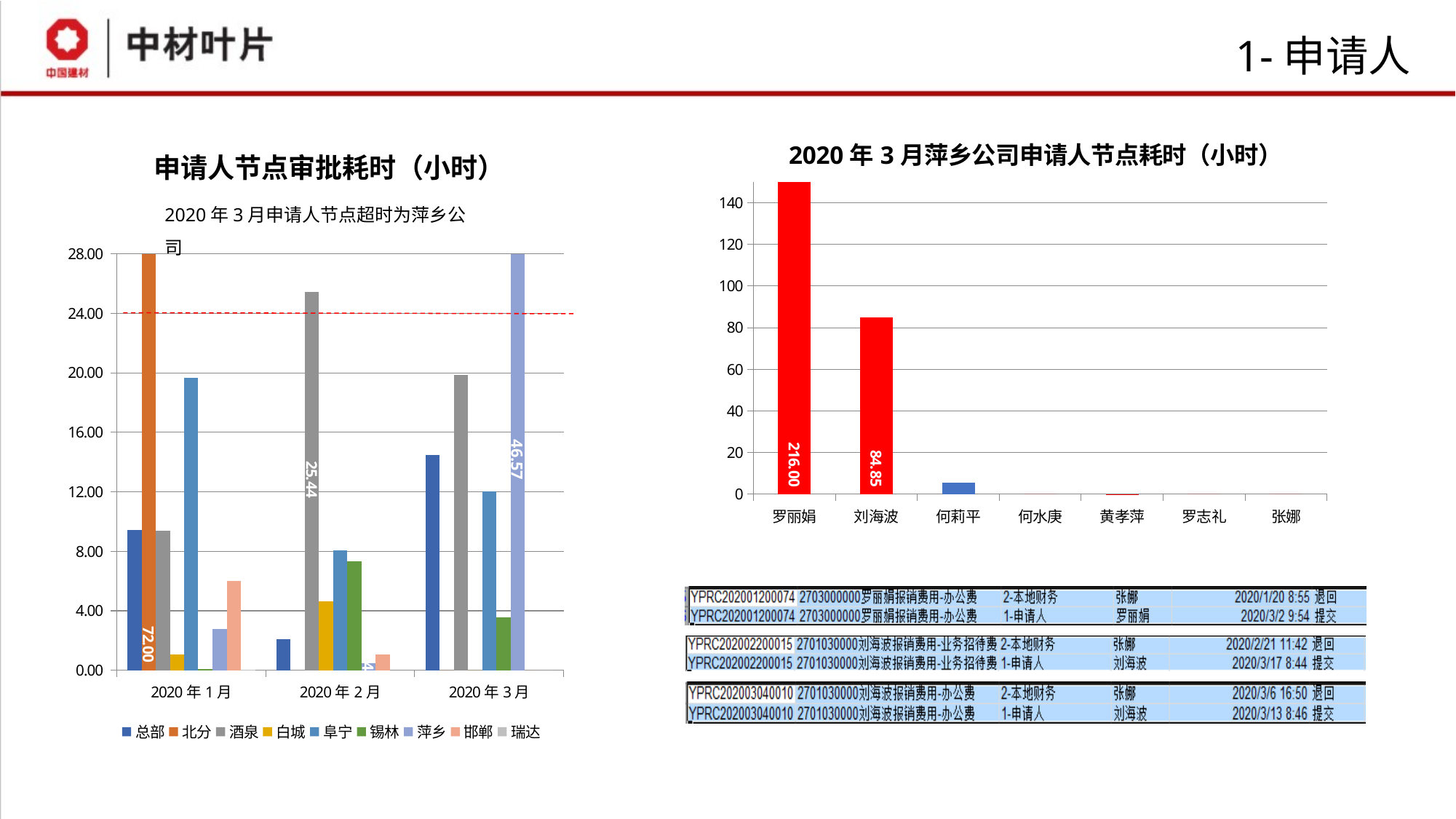
In the chart titled 2020年3月萍乡公司申请人节点耗时（小时）, what is the value for 刘海波? 84.85 In the chart titled 2020年3月萍乡公司申请人节点耗时（小时）, what is the difference between the values for 罗丽娟 and 刘海波? 131.15 In the chart titled 申请人节点审批耗时（小时）, what is the value for 北分 in 2020年1月? 72.00 In the chart titled 申请人节点审批耗时（小时）, is the value for 阜宁 in 2020年1月 greater or less than 16.00? greater What kind of chart is the one titled 2020年3月萍乡公司申请人节点耗时（小时）? bar chart In the chart titled 2020年3月萍乡公司申请人节点耗时（小时）, which person has the highest value? 罗丽娟 In the chart titled 申请人节点审批耗时（小时）, what is the value for 酒泉 in 2020年2月? 25.44 In the chart titled 2020年3月萍乡公司申请人节点耗时（小时）, what is the value for 罗丽娟? 216.00 In the chart titled 申请人节点审批耗时（小时）, how many series does the legend list? 9 In the chart titled 2020年3月萍乡公司申请人节点耗时（小时）, how many people are shown on the x axis? 7 In the chart titled 申请人节点审批耗时（小时）, what is the value for 萍乡 in 2020年3月? 46.57 In the chart titled 2020年3月萍乡公司申请人节点耗时（小时）, which is larger, the value for 何莉平 or the value for 何水庚? 何莉平